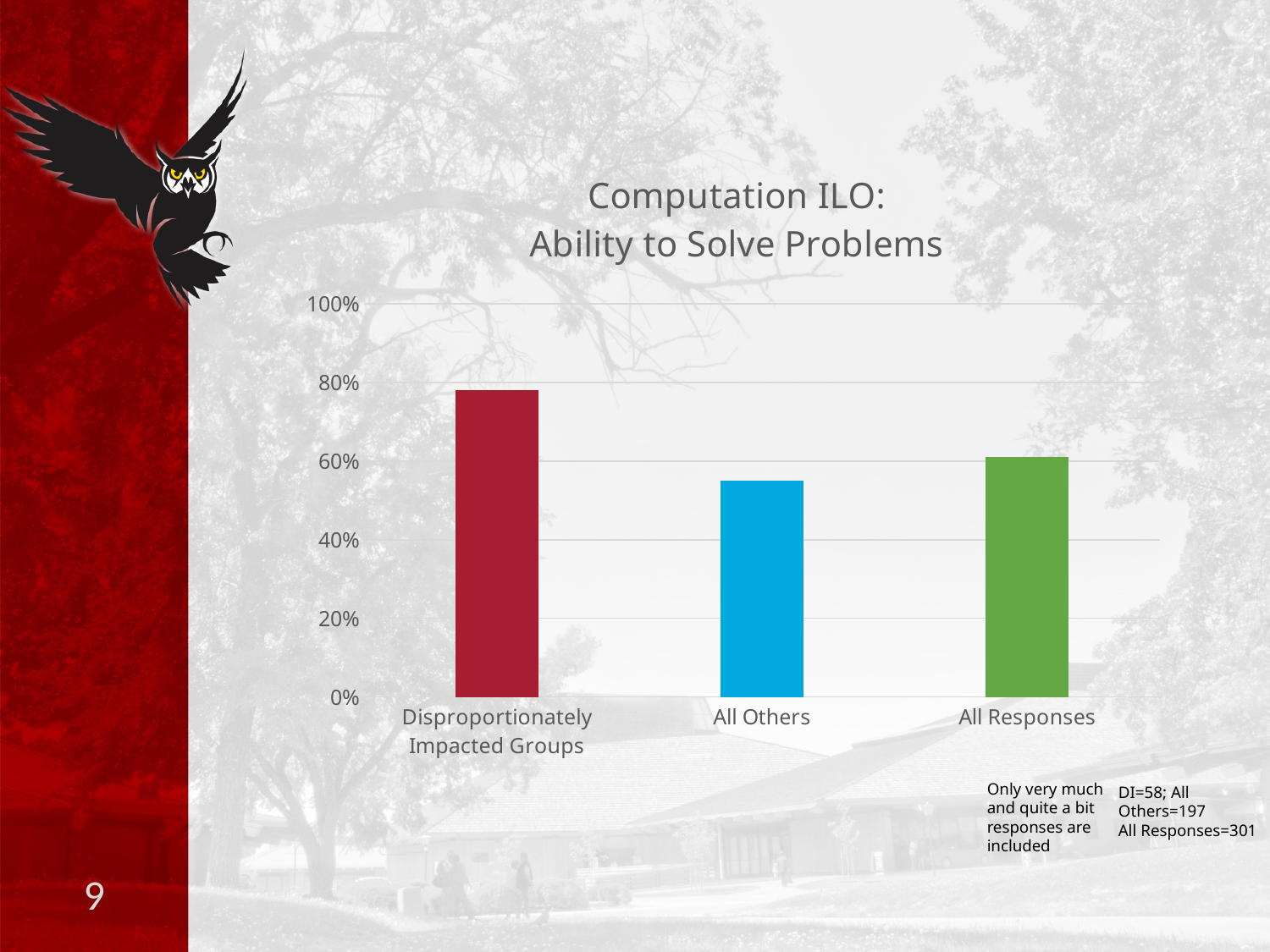
How many categories are shown on the x axis of the chart? 3 Is the value for All Responses greater or less than 40%? greater Which category has the lowest value in the chart? All Others What colour is the bar for All Others? blue Which category has the highest value in the chart? Disproportionately Impacted Groups What kind of chart is shown on the slide? bar chart What is the title of the chart? Computation ILO: Ability to Solve Problems Is the value for All Others greater or less than 40%? greater Which is larger, the value for Disproportionately Impacted Groups or the value for All Others? Disproportionately Impacted Groups Is the value for All Responses greater or less than 80%? less